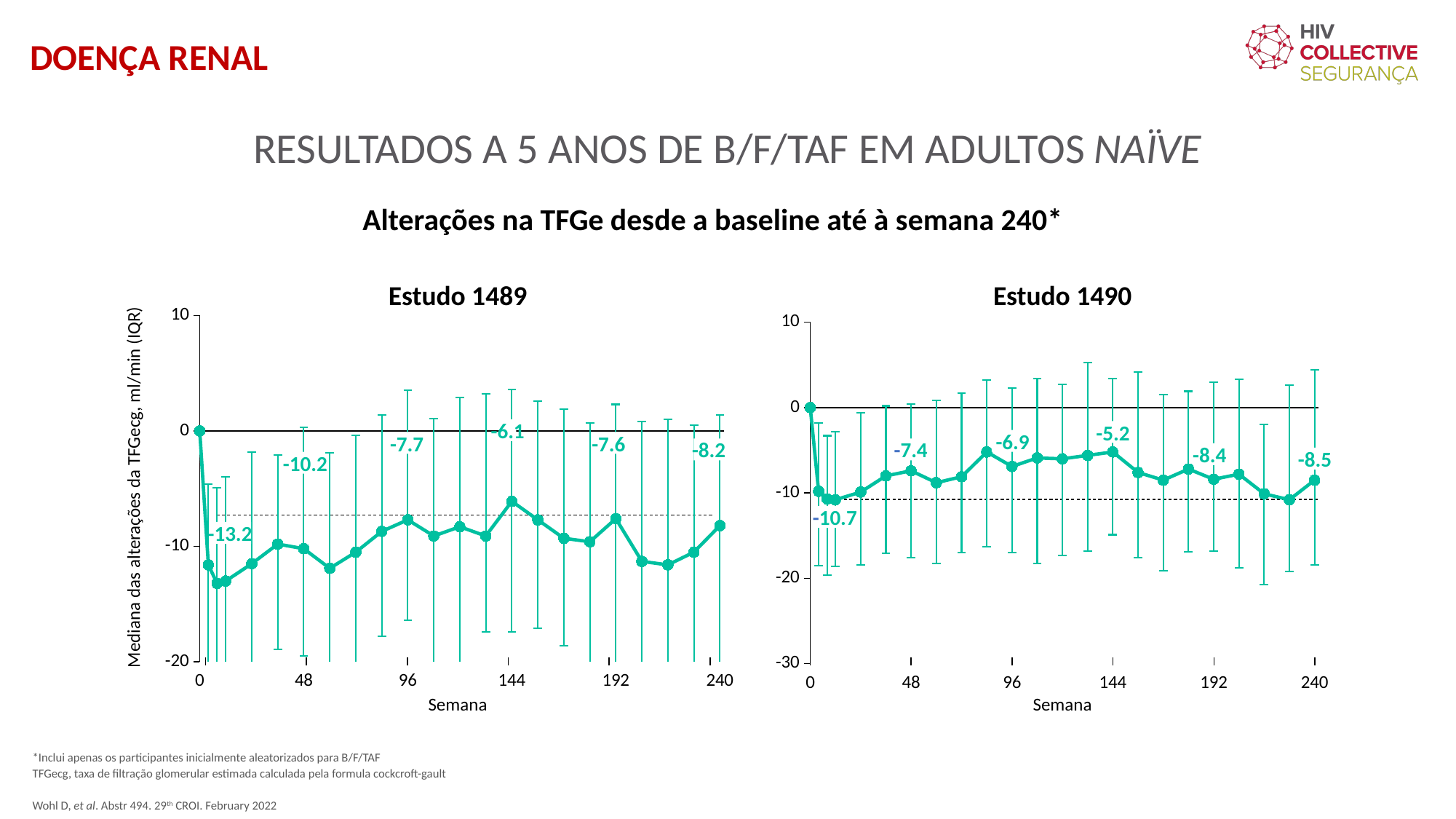
In the Estudo 1489 chart, is the value at week 240 greater or less than -10? greater In the Estudo 1490 chart, what is the labelled value at week 48? -7.4 In the Estudo 1490 chart, which labelled value is the highest? -5.2 In the Estudo 1489 chart, what is the labelled value at week 240? -8.2 In the Estudo 1490 chart, what is the labelled value at week 144? -5.2 What is the y-axis label of the charts? Mediana das alterações da TFGecg, ml/min (IQR) In the Estudo 1489 chart, what is the labelled value at week 144? -6.1 In the Estudo 1489 chart, which labelled value is the lowest? -13.2 What kind of chart is used for Estudo 1489? line chart Which study shows the larger (more negative) change at week 240, Estudo 1489 or Estudo 1490? Estudo 1490 What is the difference between the week 240 values of Estudo 1489 (-8.2) and Estudo 1490 (-8.5)? 0.3 In the Estudo 1490 chart, what is the labelled value at week 240? -8.5